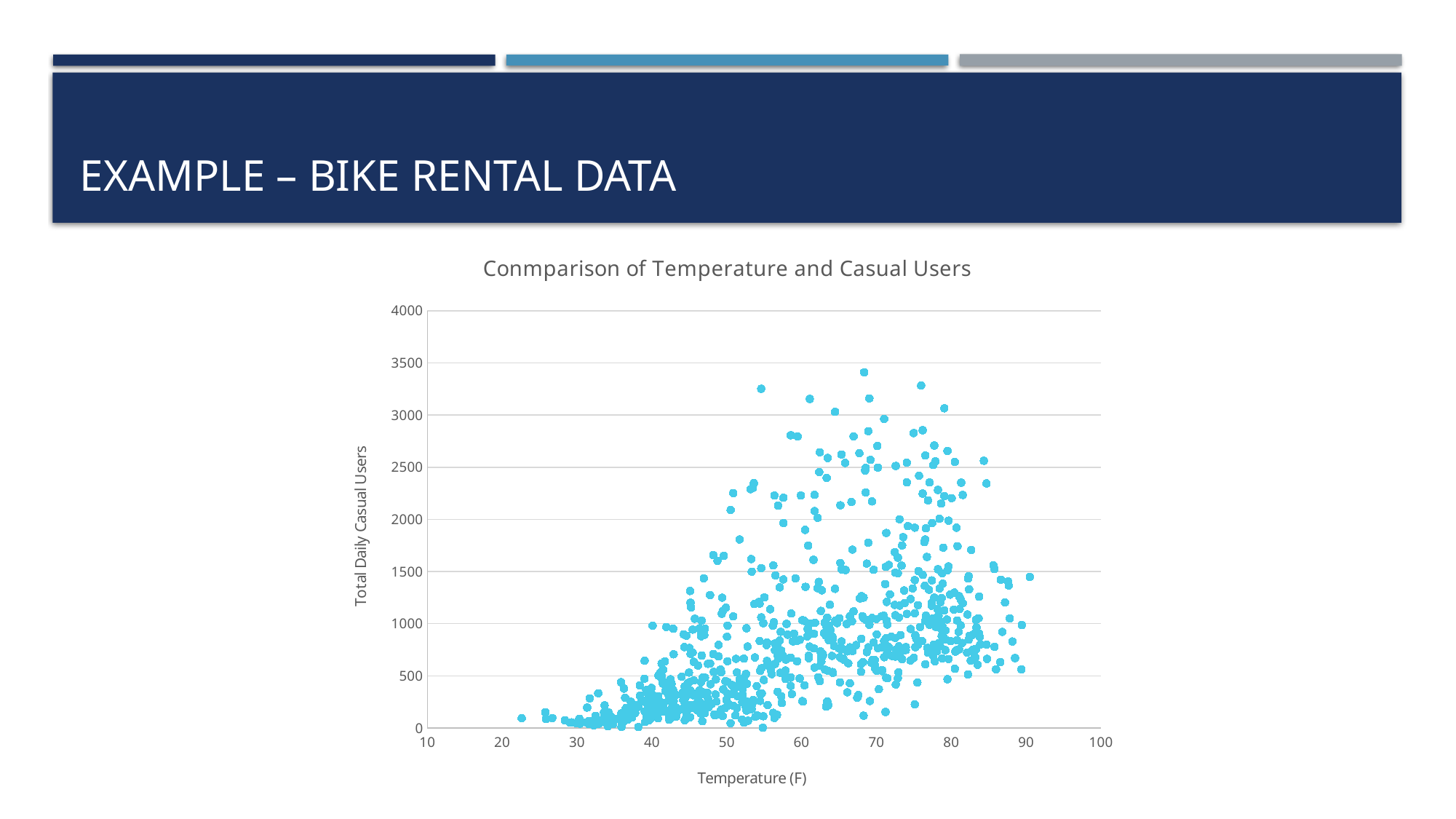
What is the title of the chart? Conmparison of Temperature and Casual Users Is the highest value of Total Daily Casual Users on the chart greater or less than 3500? less What is the label of the x axis of the chart? Temperature (F) What kind of chart is shown on the slide? Scatter plot Is the highest temperature plotted on the chart greater or less than 100? less Is the highest value of Total Daily Casual Users on the chart greater or less than 3000? greater Do the Total Daily Casual Users values generally rise or fall as temperature increases from 20 to 70? rise